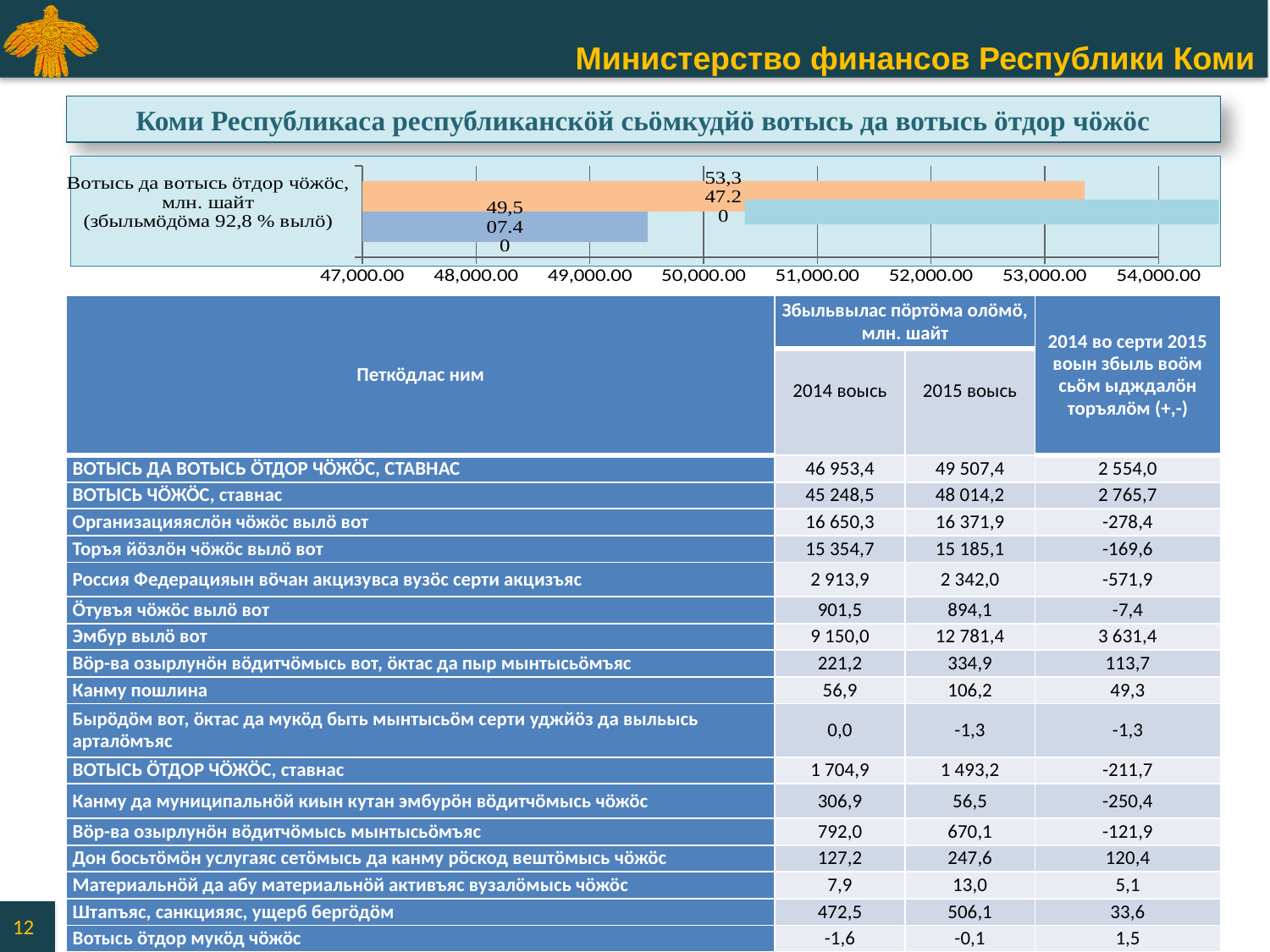
What is the highest value shown on the chart's horizontal axis? 54,000.00 How many categories does the chart's vertical axis list? 1 Which is larger, the orange bar or the dark blue bar? orange bar How many bars are plotted in the chart? 3 Which bar is the shortest in the chart: the orange, the light blue, or the dark blue one? dark blue Is the value of the dark blue bar greater or less than 50,000.00? less What is the lowest value shown on the chart's horizontal axis? 47,000.00 Is the value of the orange bar greater or less than 53,000.00? greater What kind of chart is shown on the slide? bar chart